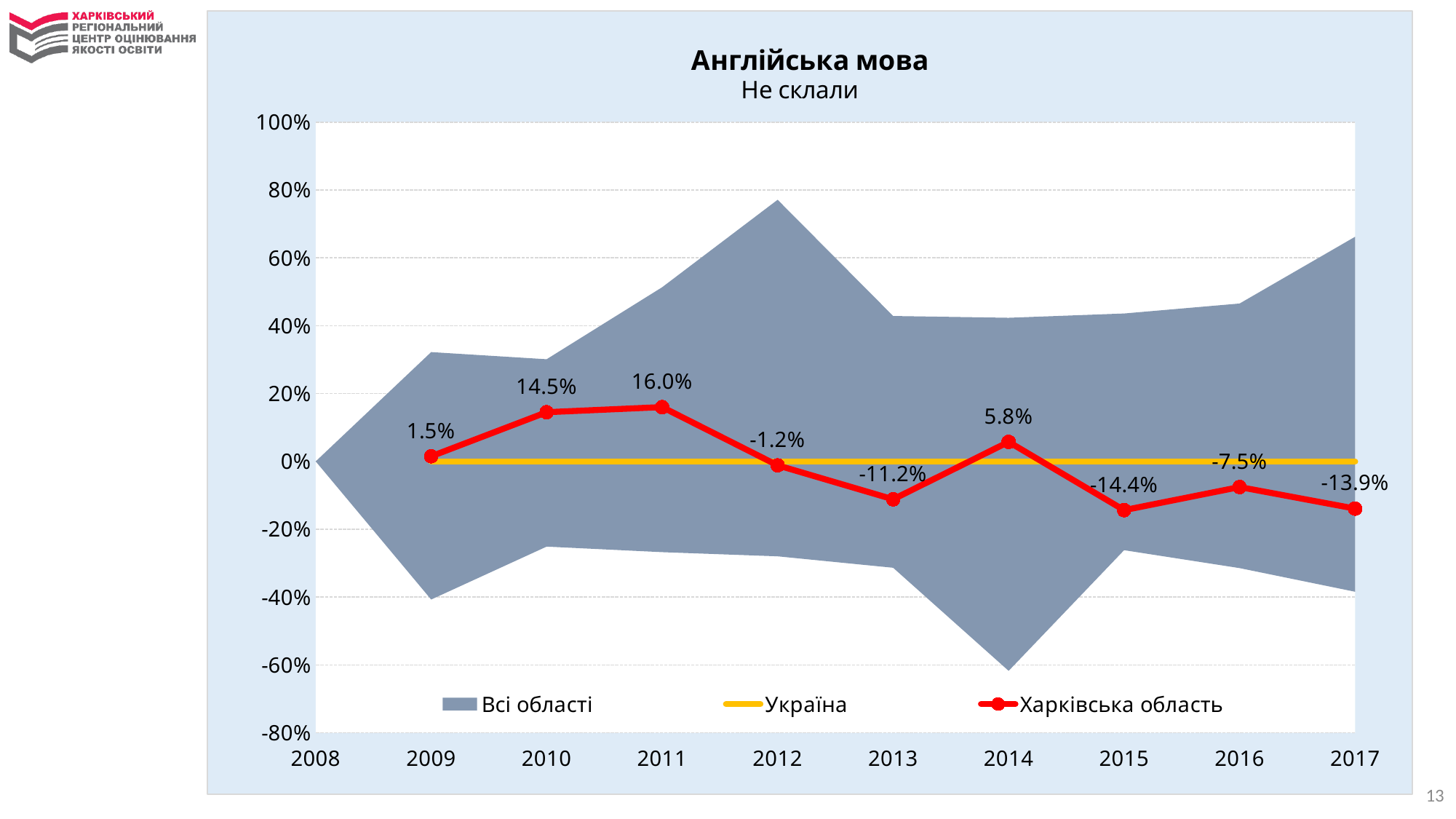
How many series does the legend list? 3 How many data points with labels does the Харківська область series have? 9 What is the main title of the chart? Англійська мова What is the value for Харківська область in 2011? 16.0% In which year does the Харківська область series reach its lowest value? 2015 Which is larger for Харківська область: the value in 2014 or the value in 2016? 2014 What is the difference between the Харківська область values for 2011 and 2010? 1.5% In which year does the Харківська область series reach its highest value? 2011 What is the value for Харківська область in 2009? 1.5% Is the value for Харківська область in 2013 greater or less than 0%? less Does the Харківська область series rise or fall from 2014 to 2015? fall What is the value for Харківська область in 2015? -14.4%